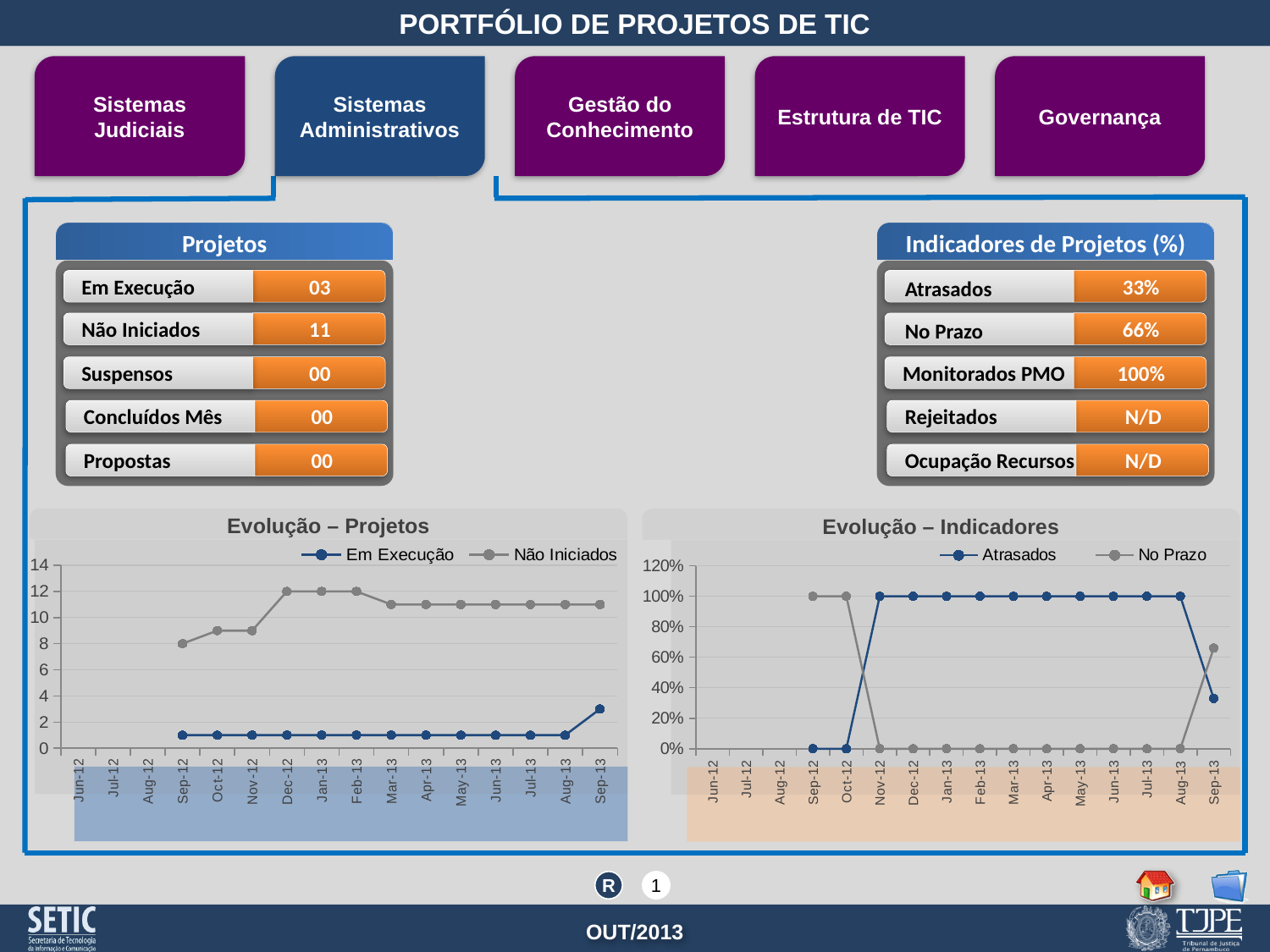
In the "Evolução – Projetos" chart, what is the value of Não Iniciados at Sep-12? 8 In the "Evolução – Indicadores" chart, what is the value of No Prazo at Sep-12? 100% In the "Evolução – Indicadores" chart, which series has the higher value at Sep-13, Atrasados or No Prazo? No Prazo How many series does the legend of the "Evolução – Projetos" chart list? 2 In the "Evolução – Projetos" chart, is the value of Em Execução at Jun-13 greater or less than 2? less In the "Evolução – Indicadores" chart, what is the value of Atrasados at Mar-13? 100% In the "Evolução – Projetos" chart, what is the value of Não Iniciados at Dec-12? 12 In the "Evolução – Projetos" chart, is the value of Não Iniciados at Mar-13 greater or less than 10? greater How many series does the legend of the "Evolução – Indicadores" chart list? 2 In the "Evolução – Projetos" chart, does the Em Execução line rise or fall between Aug-13 and Sep-13? rise In the "Evolução – Projetos" chart, which series has the higher value at Sep-13, Em Execução or Não Iniciados? Não Iniciados What kind of chart is the "Evolução – Projetos" chart? line chart